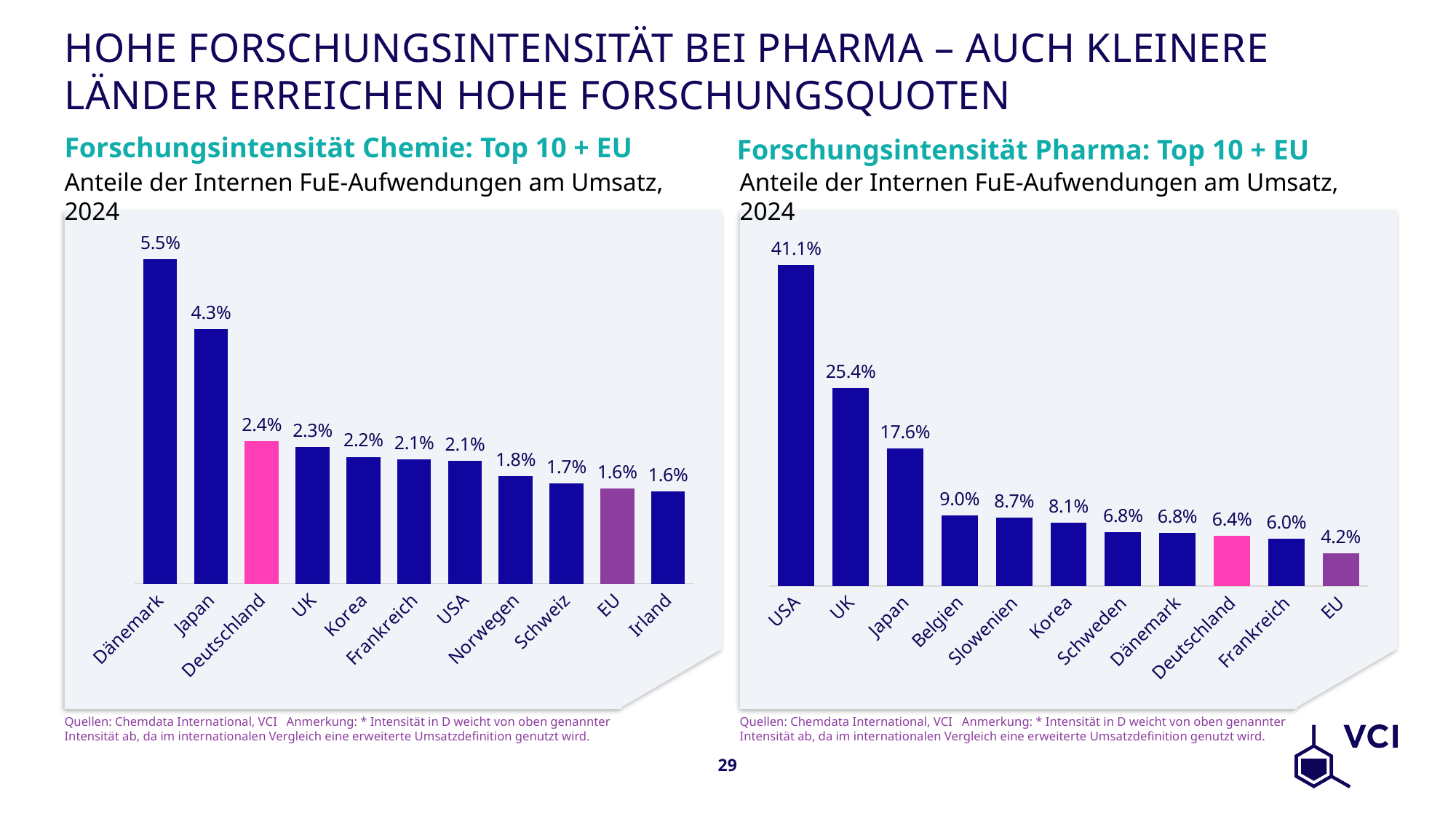
In the 'Forschungsintensität Chemie: Top 10 + EU' chart, what is the difference between Dänemark and Japan? 1.2% In the 'Forschungsintensität Pharma: Top 10 + EU' chart, which is larger, Belgien or Korea? Belgien In the 'Forschungsintensität Pharma: Top 10 + EU' chart, which category has the lowest value? EU In the 'Forschungsintensität Chemie: Top 10 + EU' chart, do the values rise or fall from left to right? Fall In the 'Forschungsintensität Pharma: Top 10 + EU' chart, what is the value for Deutschland? 6.4% How many bars are shown in the 'Forschungsintensität Pharma: Top 10 + EU' chart? 11 How many bars are shown in the 'Forschungsintensität Chemie: Top 10 + EU' chart? 11 In the 'Forschungsintensität Pharma: Top 10 + EU' chart, what is the difference between UK and Japan? 7.8% What kind of chart is the 'Forschungsintensität Pharma: Top 10 + EU' chart? Bar chart In the 'Forschungsintensität Chemie: Top 10 + EU' chart, what is the value for Deutschland? 2.4% In the 'Forschungsintensität Pharma: Top 10 + EU' chart, what is the value for USA? 41.1% In the 'Forschungsintensität Chemie: Top 10 + EU' chart, which country has the highest value? Dänemark